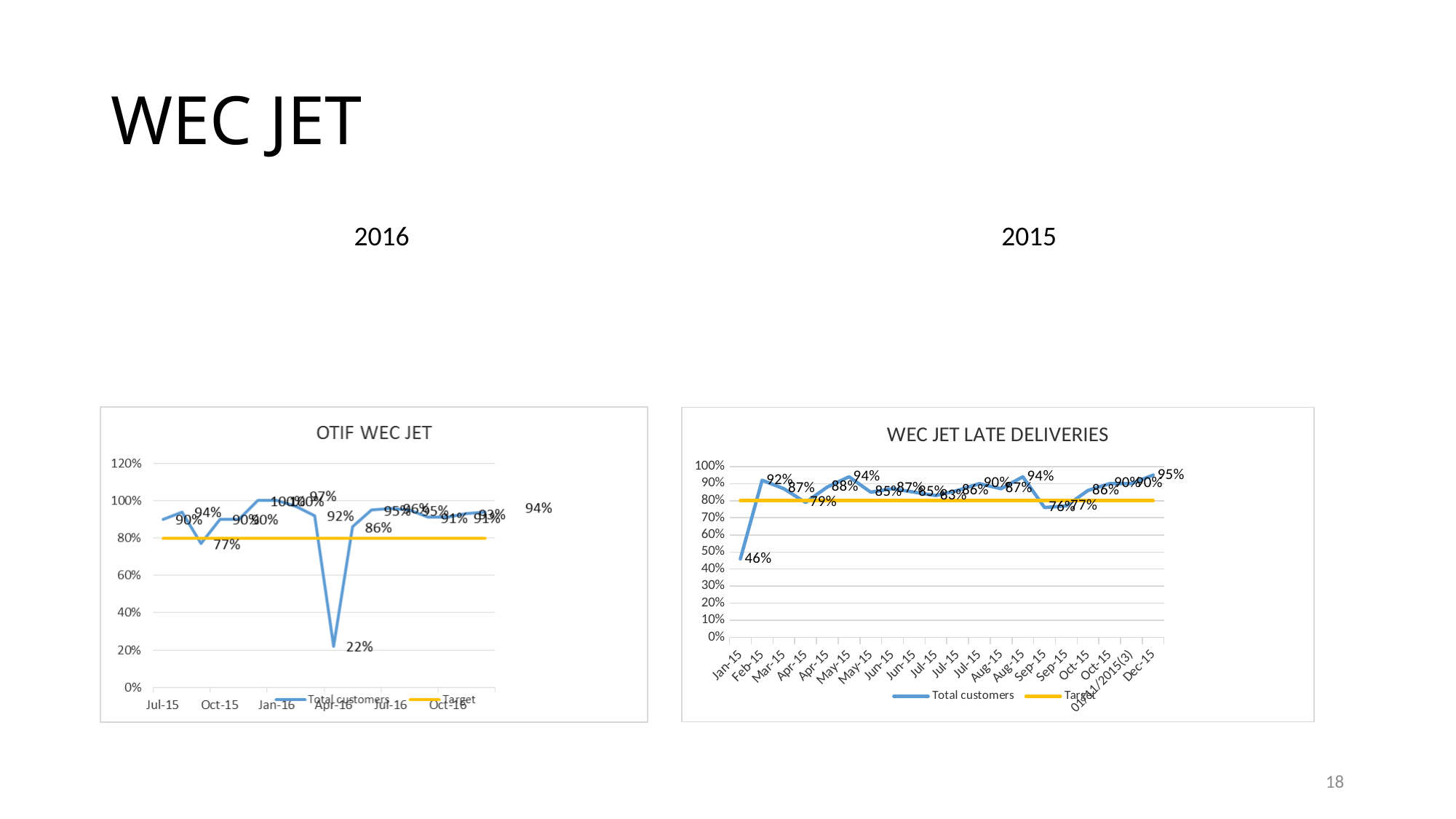
In the 'WEC JET LATE DELIVERIES' chart, is the Target line greater or less than 70%? greater What kind of chart is the 'OTIF WEC JET' chart? line chart In the 'WEC JET LATE DELIVERIES' chart, which month has the lowest Total customers value? Jan-15 In the 'WEC JET LATE DELIVERIES' chart, what is the difference between the Dec-15 and Jan-15 Total customers values? 49 percentage points In the 'WEC JET LATE DELIVERIES' chart, what is the Total customers value for Dec-15? 95% In the 'OTIF WEC JET' chart, is the Target line greater or less than 100%? less In the 'WEC JET LATE DELIVERIES' chart, which is larger, the Total customers value for Jan-15 or for Dec-15? Dec-15 How many series does the legend of the 'OTIF WEC JET' chart list? 2 In the 'OTIF WEC JET' chart, what is the highest value labelled on the Total customers line? 100% In the 'OTIF WEC JET' chart, what is the lowest value labelled on the Total customers line? 22% What are the two legend entries in the 'WEC JET LATE DELIVERIES' chart? Total customers and Target In the 'WEC JET LATE DELIVERIES' chart, what is the Total customers value for Jan-15? 46%